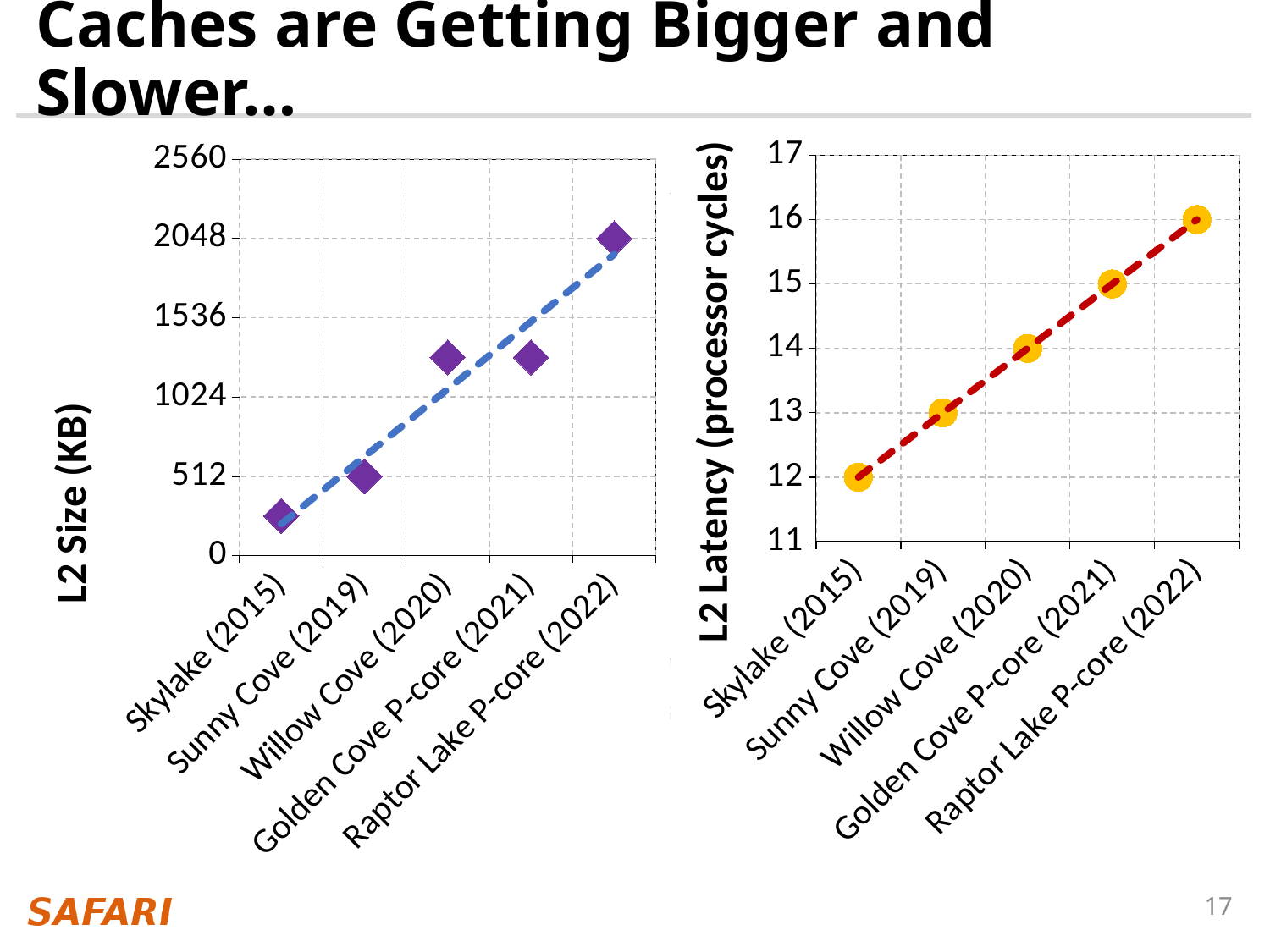
In the L2 Size chart on the left, which processor has the smallest L2 size? Skylake (2015) In the L2 Size chart on the left, what is the L2 size for Raptor Lake P-core (2022)? 2048 In the L2 Size chart on the left, what is the L2 size for Sunny Cove (2019)? 512 In the L2 Latency chart on the right, which processor has the highest L2 latency? Raptor Lake P-core (2022) In the L2 Latency chart on the right, do the values rise or fall from Skylake (2015) to Raptor Lake P-core (2022)? rise In the L2 Latency chart on the right, what is the L2 latency for Willow Cove (2020)? 14 In the L2 Latency chart on the right, how many processor cycles higher is the latency of Raptor Lake P-core (2022) than Skylake (2015)? 4 In the L2 Latency chart on the right, what is the L2 latency for Skylake (2015)? 12 In the L2 Size chart on the left, is the value for Skylake (2015) greater or less than 512? less In the L2 Size chart on the left, is the value for Willow Cove (2020) greater or less than 1024? greater In the L2 Latency chart on the right, what is the L2 latency for Raptor Lake P-core (2022)? 16 In the L2 Size chart on the left, how many processors are plotted? 5